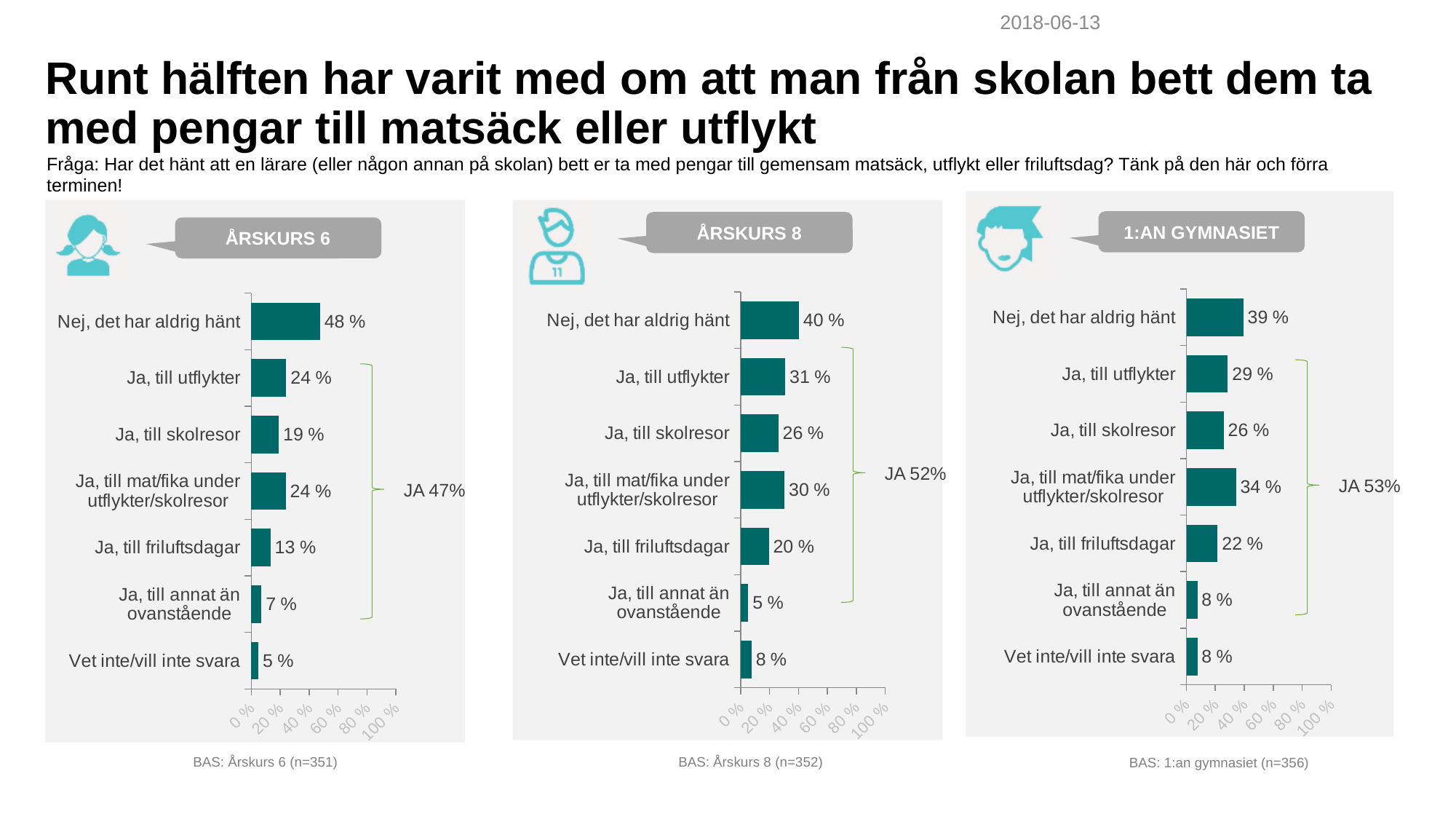
In the ÅRSKURS 6 chart, what is the difference between "Ja, till utflykter" and "Ja, till friluftsdagar"? 11 % What kind of chart is the 1:AN GYMNASIET chart? Bar chart In the ÅRSKURS 6 chart, is the value for "Nej, det har aldrig hänt" greater or less than 40 %? greater How many categories does the ÅRSKURS 6 chart show? 7 In the ÅRSKURS 6 chart, what is the value for "Nej, det har aldrig hänt"? 48 % In the ÅRSKURS 8 chart, which is larger: "Ja, till skolresor" or "Ja, till friluftsdagar"? Ja, till skolresor In the ÅRSKURS 8 chart, what is the value for "Ja, till utflykter"? 31 % In the ÅRSKURS 6 chart, which category has the lowest value? Vet inte/vill inte svara In the 1:AN GYMNASIET chart, what is the value for "Ja, till mat/fika under utflykter/skolresor"? 34 % In the 1:AN GYMNASIET chart, what is the difference between "Nej, det har aldrig hänt" and "Ja, till utflykter"? 10 % In the ÅRSKURS 8 chart, which category has the highest value? Nej, det har aldrig hänt What combined "JA" share is annotated next to the ÅRSKURS 8 chart? JA 52%